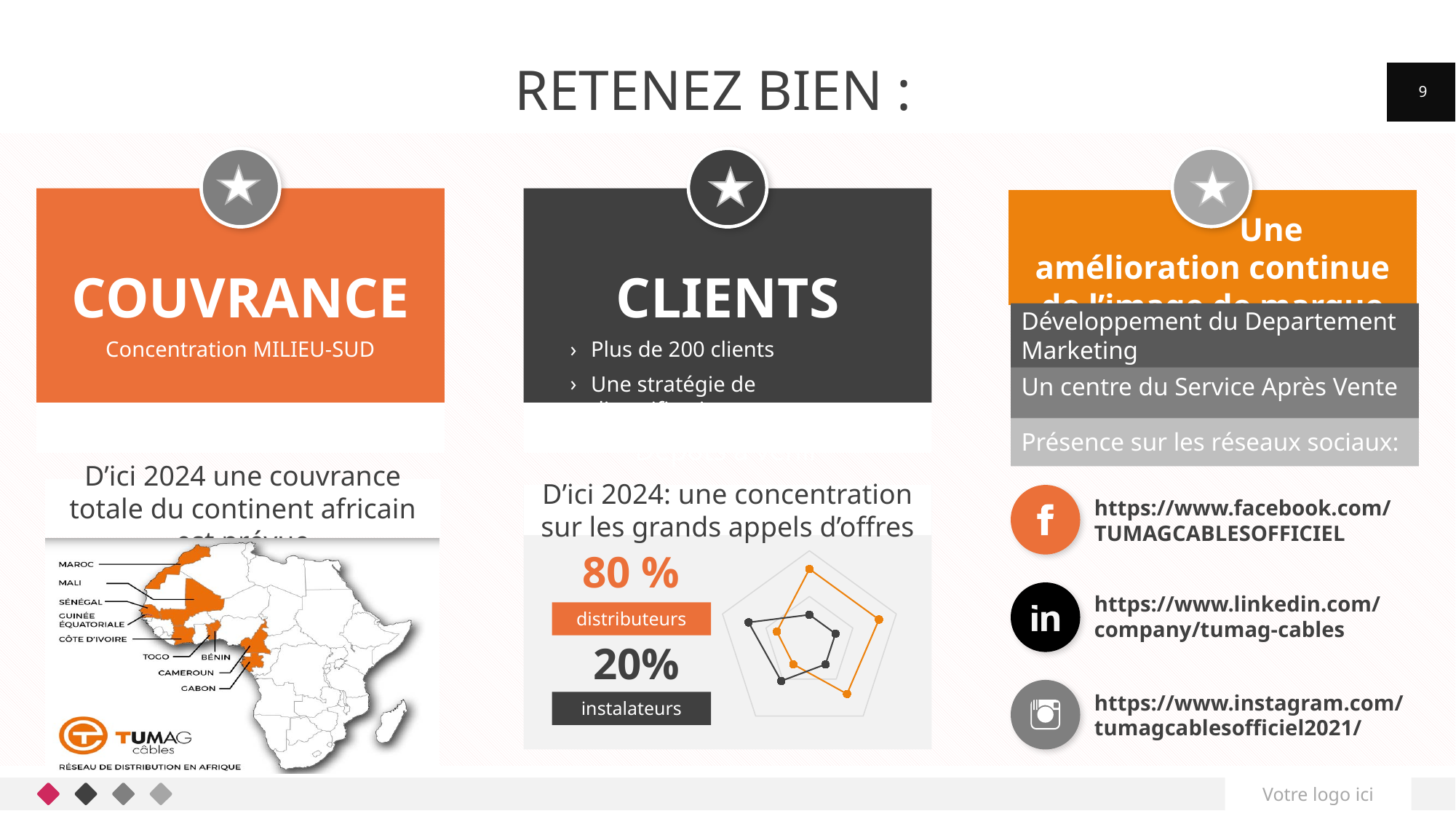
What kind of chart is shown in the CLIENTS section of the slide? radar chart Which series on the radar chart covers the larger area, the orange one or the dark grey one? orange What percentage is shown for distributeurs next to the radar chart? 80 % How many data series are plotted on the radar chart in the CLIENTS section? 2 What percentage is shown for instalateurs next to the radar chart? 20% How many axes (points) does the radar chart in the CLIENTS section have? 5 Which group has the larger share, distributeurs or instalateurs? distributeurs What is the difference in percentage points between distributeurs and instalateurs? 60